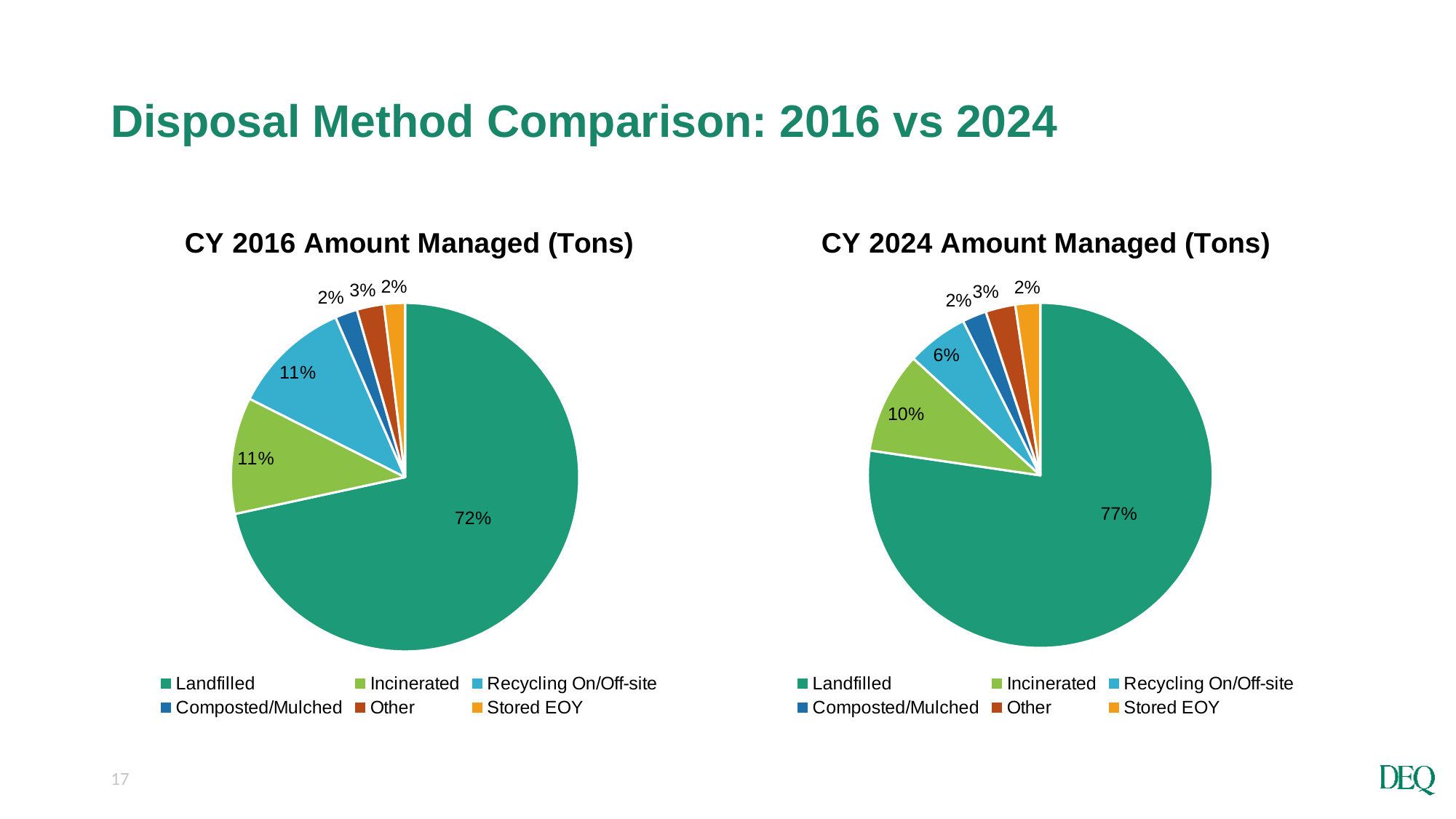
In the CY 2016 Amount Managed (Tons) chart, what share is Incinerated? 11% What is the difference between the Landfilled share in the CY 2024 chart and the Landfilled share in the CY 2016 chart? 5% In the CY 2024 Amount Managed (Tons) chart, what share is Landfilled? 77% How many categories does the legend of the CY 2024 Amount Managed (Tons) chart list? 6 What type of chart is the CY 2016 Amount Managed (Tons) chart? Pie chart In the CY 2016 Amount Managed (Tons) chart, what colour is the Stored EOY slice? Orange In the CY 2016 Amount Managed (Tons) chart, what share is Landfilled? 72% In the CY 2024 Amount Managed (Tons) chart, what share is Recycling On/Off-site? 6% In the CY 2024 Amount Managed (Tons) chart, what share is Other? 3% What is the difference between the Recycling On/Off-site share in the CY 2016 chart and in the CY 2024 chart? 5% In the CY 2016 Amount Managed (Tons) chart, which category has the largest share? Landfilled Which is larger: the Incinerated share in the CY 2016 chart or the Incinerated share in the CY 2024 chart? CY 2016